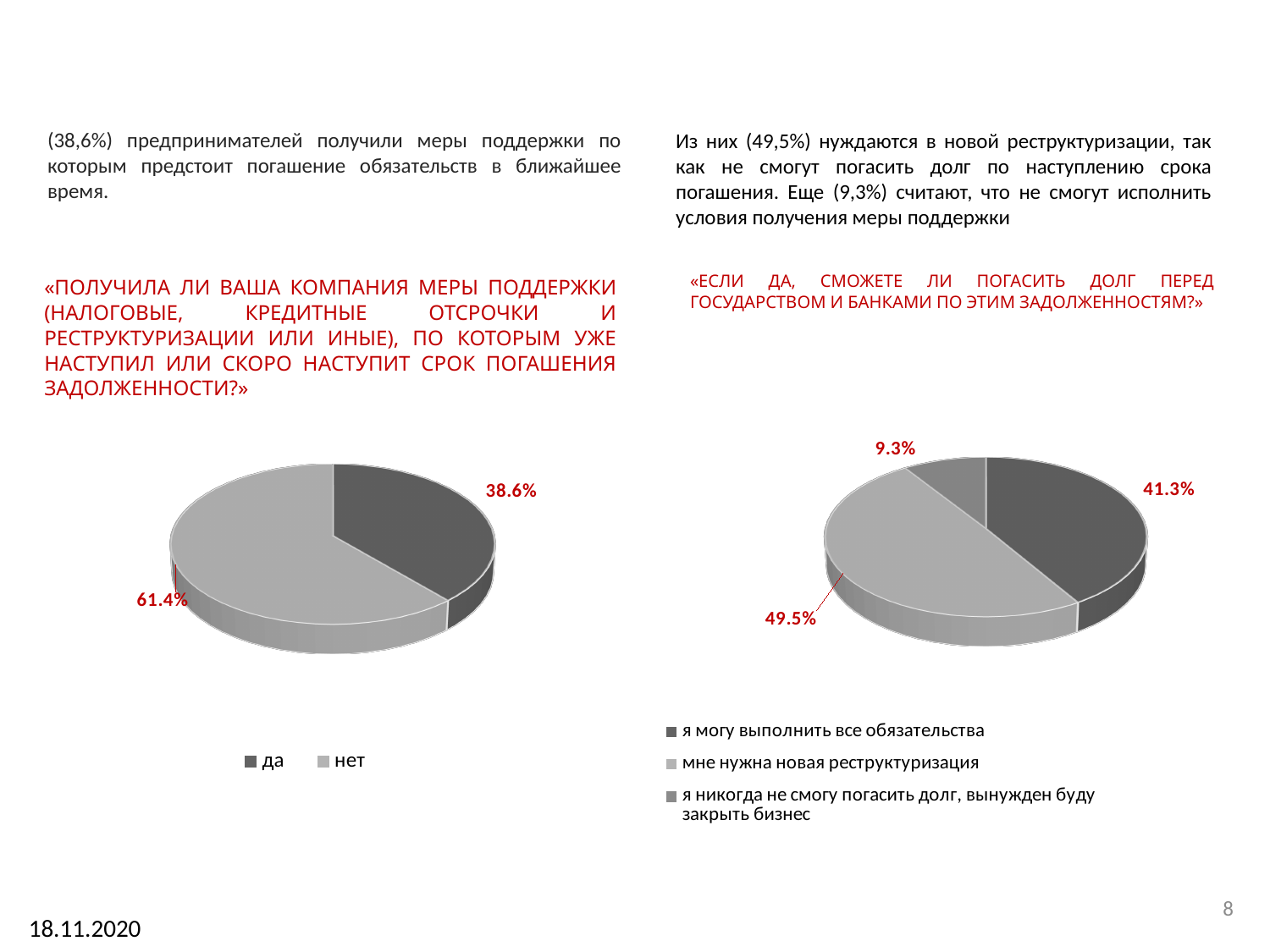
In the right pie chart, what is the difference between the «мне нужна новая реструктуризация» share and the «я могу выполнить все обязательства» share? 8.2% In the left pie chart, what share of respondents answered «нет»? 61.4% In the right pie chart, which category has the largest share? мне нужна новая реструктуризация In the left pie chart, which answer has the larger share, «да» or «нет»? нет In the left pie chart, what share of respondents answered «да»? 38.6% In the left pie chart, what is the difference between the «нет» share and the «да» share? 22.8% In the right pie chart, what share corresponds to «мне нужна новая реструктуризация»? 49.5% What type of chart is shown on the left side of the slide? pie chart In the right pie chart, which category has the smallest share? я никогда не смогу погасить долг, вынужден буду закрыть бизнес In the right pie chart, what share corresponds to «я могу выполнить все обязательства»? 41.3% How many slices does the right pie chart have? 3 How many entries does the legend of the left chart list? 2